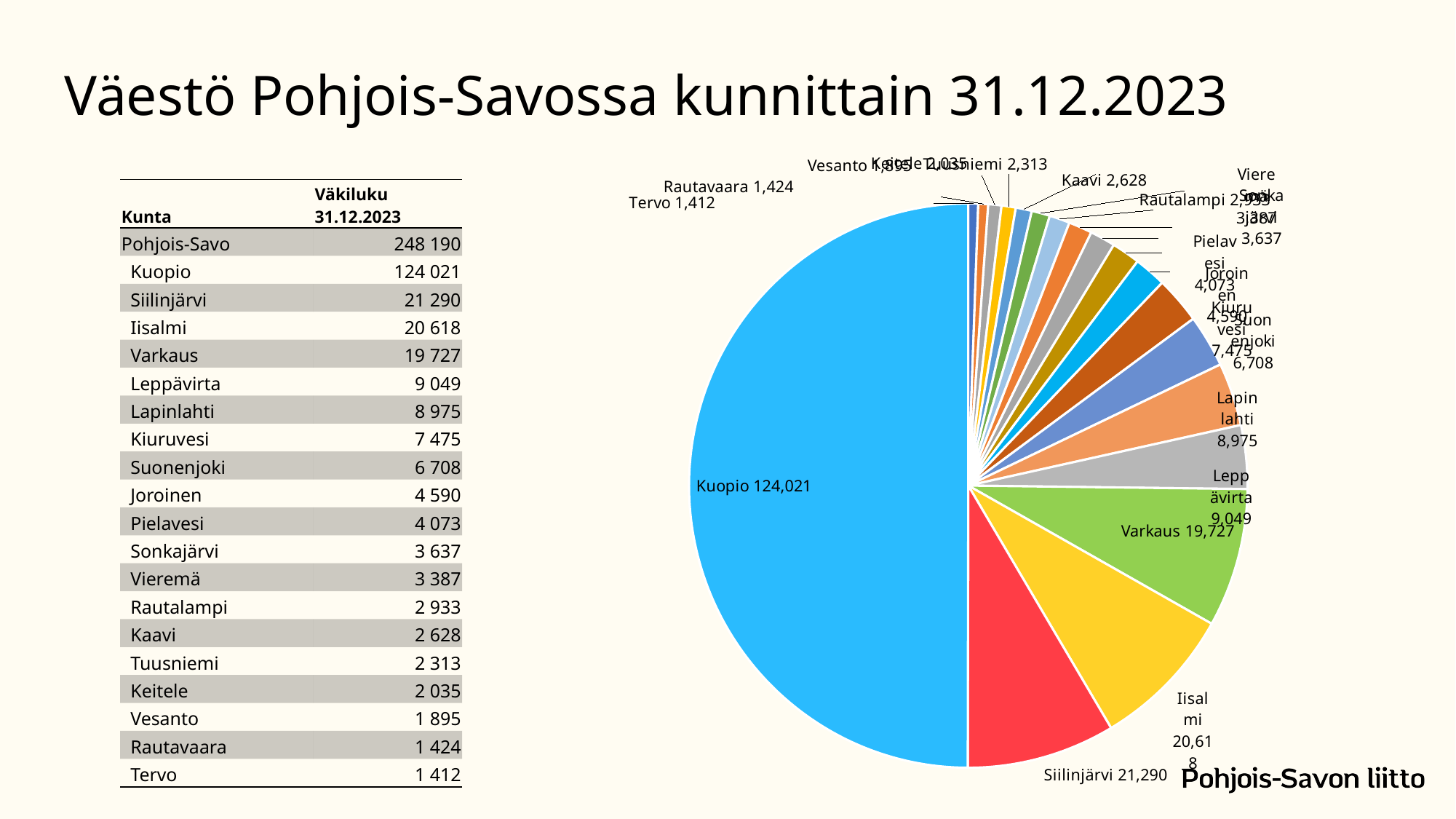
Which slice is larger in the pie chart, Siilinjärvi or Iisalmi? Siilinjärvi What is the title of the slide containing the pie chart? Väestö Pohjois-Savossa kunnittain 31.12.2023 What value is labelled for Kaavi in the pie chart? 2,628 What value is labelled for Lapinlahti in the pie chart? 8,975 How many municipality slices does the pie chart contain? 19 Which municipality has the smallest slice in the pie chart? Tervo Which municipality has the largest slice in the pie chart? Kuopio What is the population value shown for Varkaus in the pie chart? 19,727 What is the difference between the values for Siilinjärvi and Iisalmi in the pie chart? 672 What is the difference between the values for Varkaus and Leppävirta in the pie chart? 10,678 What colour is the Kuopio slice in the pie chart? light blue What kind of chart is shown on the slide? pie chart